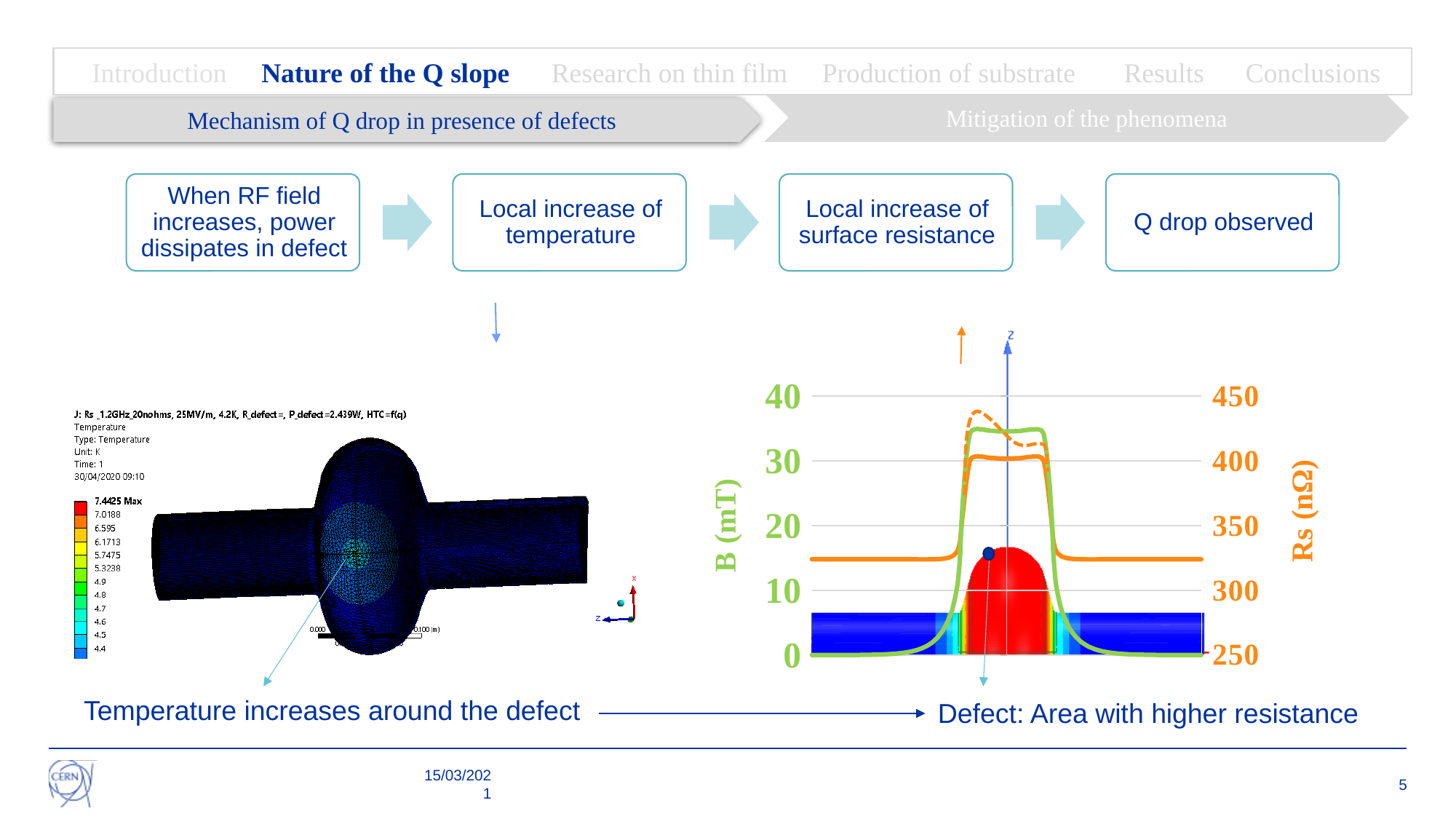
In the chart on the right, is the peak value of the green B curve greater or less than 30? greater In the chart on the right, is the peak value of the solid orange Rs curve greater or less than 350? greater What kind of chart is shown on the right side of the slide? line chart In the chart on the right, what is the label of the right vertical axis? Rs (nΩ) In the chart on the right, what is the highest tick value shown on the right Rs (nΩ) axis? 450 In the chart on the right, what is the highest tick value shown on the left B (mT) axis? 40 In the chart on the right, moving from the centre of the defect outward to the right, does the green B curve rise or fall? fall In the chart on the right, what is the lowest tick value shown on the right Rs (nΩ) axis? 250 In the chart on the right, what is the label of the left vertical axis? B (mT) In the chart on the right, is the Rs value far away from the defect (the flat part of the orange curve) greater or less than 350? less